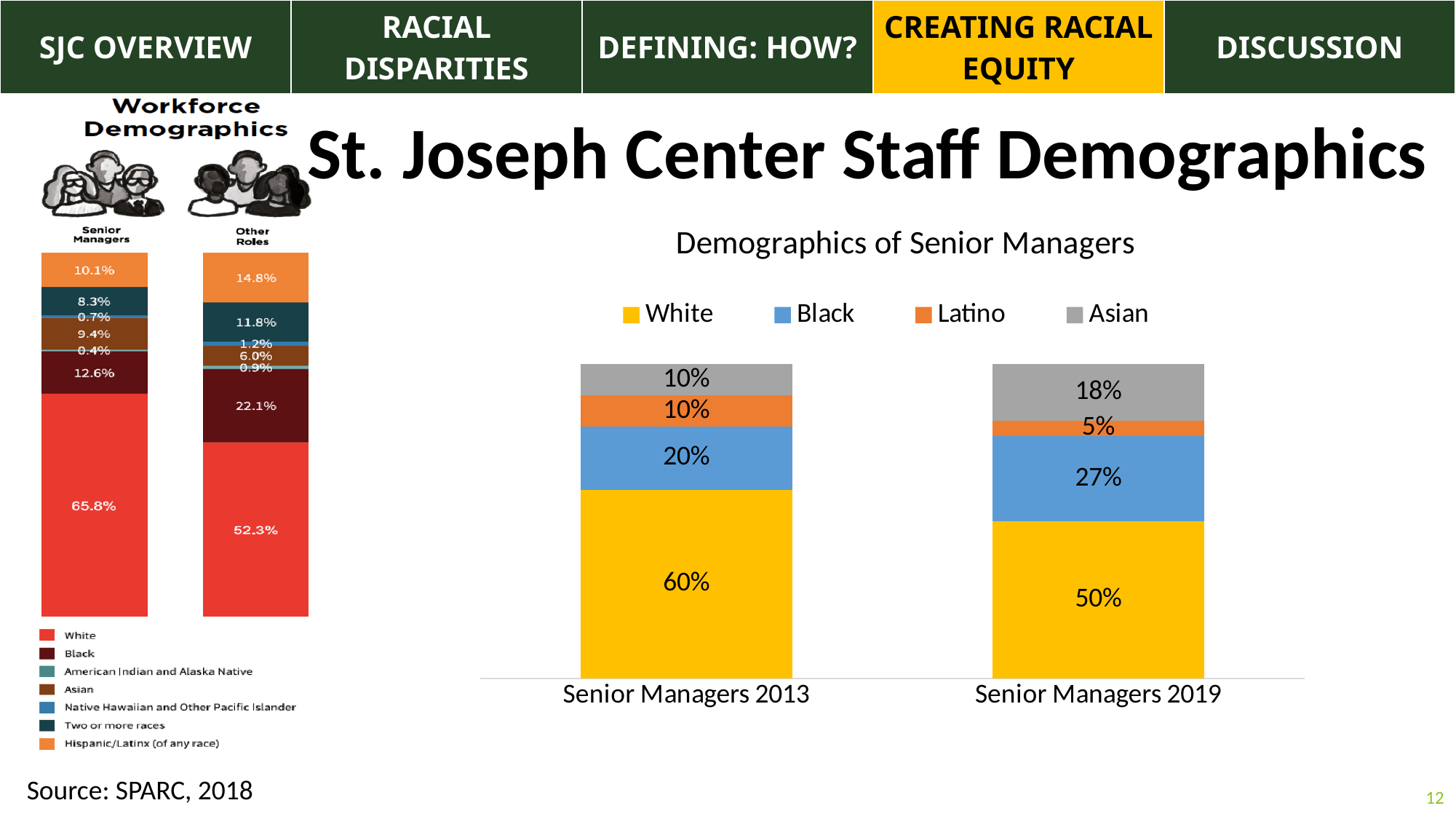
What kind of chart is the 'Demographics of Senior Managers' chart? Stacked bar chart In the 'Demographics of Senior Managers' chart, what is the difference between the White share in Senior Managers 2013 and in Senior Managers 2019? 10% In the 'Workforce Demographics' chart on the left, what is the difference between the Hispanic/Latinx share for Other Roles and for Senior Managers? 4.7% In the 'Demographics of Senior Managers' chart, which series has the smallest share in Senior Managers 2019? Latino In the 'Demographics of Senior Managers' chart, what is the value for Black in Senior Managers 2019? 27% In the 'Demographics of Senior Managers' chart, what is the value for White in Senior Managers 2013? 60% In the 'Demographics of Senior Managers' chart, which series has the largest share in Senior Managers 2019? White In the 'Demographics of Senior Managers' chart, what is the value for Asian in Senior Managers 2019? 18% How many series does the legend of the 'Demographics of Senior Managers' chart list? 4 In the 'Workforce Demographics' chart on the left, what is the Black share for Other Roles? 22.1% In the 'Demographics of Senior Managers' chart, is the Latino share larger in Senior Managers 2013 or Senior Managers 2019? Senior Managers 2013 In the 'Workforce Demographics' chart on the left, what is the White share for Senior Managers? 65.8%